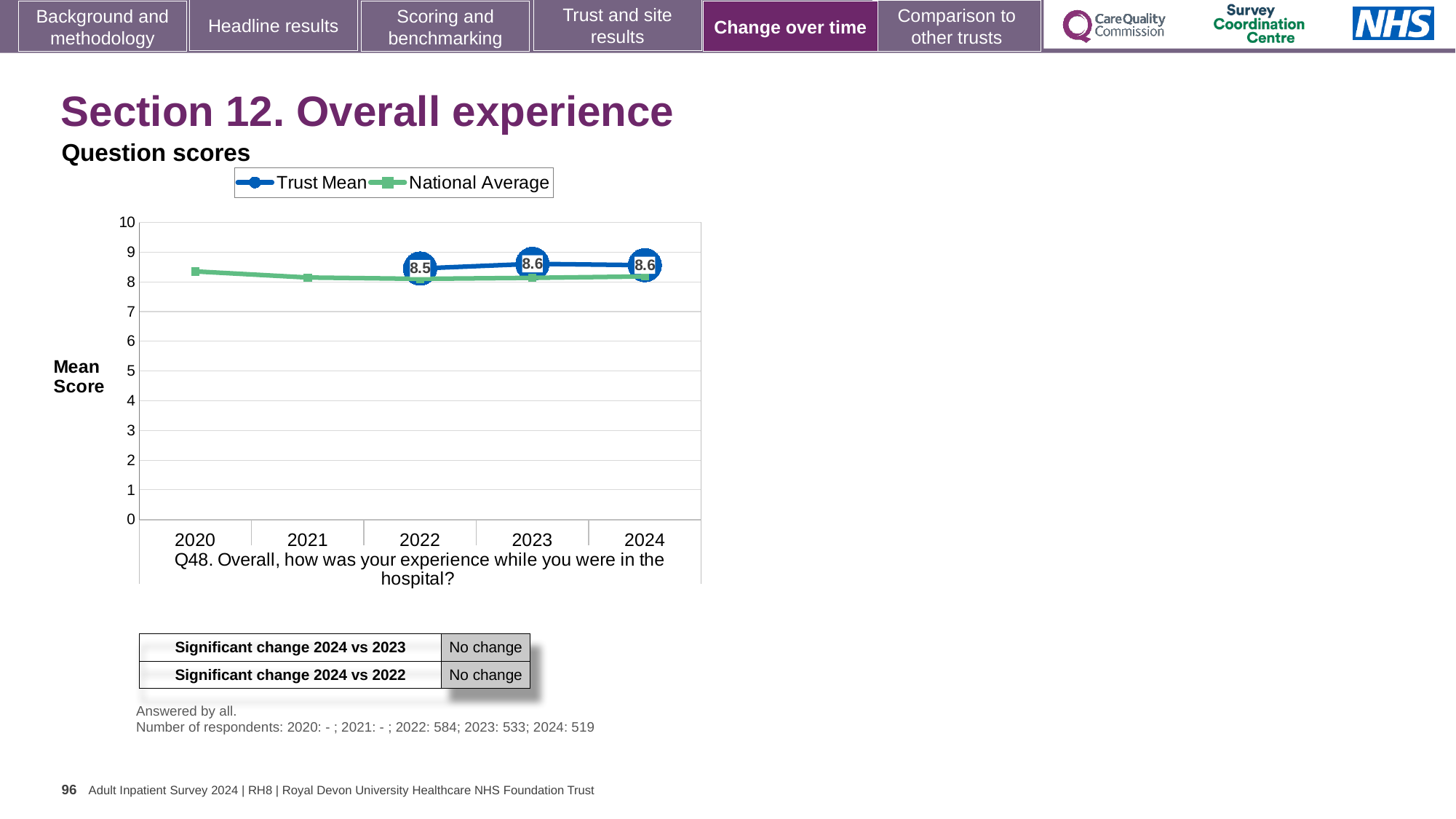
Is the National Average for 2020 greater or less than 9? less What is the Trust Mean score for 2022? 8.5 What is the Trust Mean score for 2024? 8.6 In 2023, which is higher: the Trust Mean or the National Average? Trust Mean Does the Trust Mean rise or fall from 2022 to 2024? Rise In which year is the Trust Mean lowest among the labelled values? 2022 What kind of chart is shown on the slide? Line chart What is the Trust Mean score for 2023? 8.6 What is the difference between the Trust Mean in 2023 and in 2022? 0.1 How many series does the legend list? 2 What is the label on the y axis of the chart? Mean Score How many years are shown on the x axis? 5